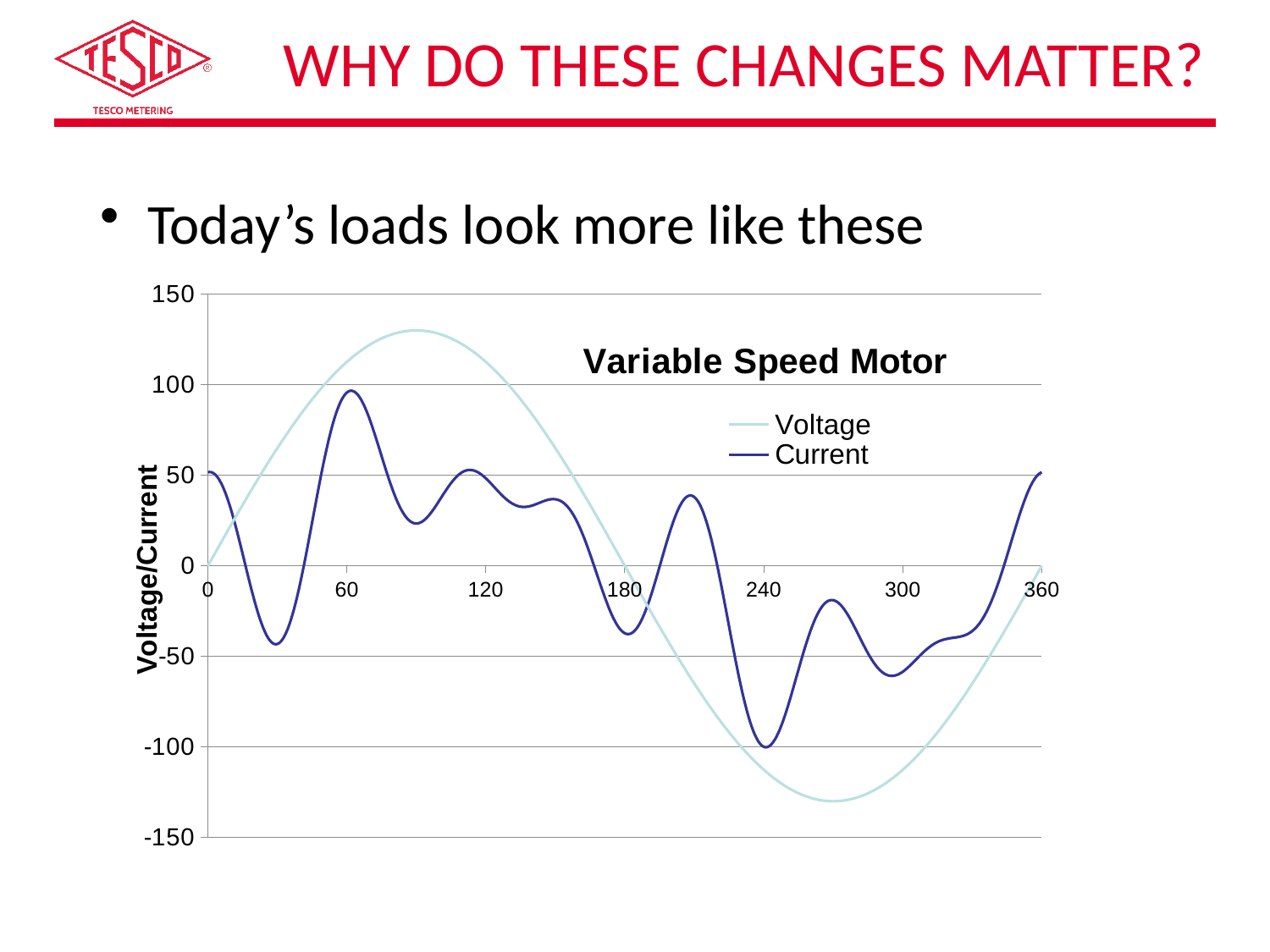
Does the Voltage line rise or fall between 90 and 270 on the x axis? fall Which series reaches the highest peak value on the chart? Voltage Is the Current value at 30 on the x axis greater or less than 0? less At 270 on the x axis, which series has the larger value, Voltage or Current? Current What is the title of the chart? Variable Speed Motor What kind of chart is shown on the slide? line chart What are the two series named in the chart legend? Voltage and Current Is the Current value at 120 on the x axis greater or less than 0? greater Is the Voltage value at 300 on the x axis greater or less than -100? less At 90 on the x axis, which series has the larger value, Voltage or Current? Voltage How many series does the chart legend list? 2